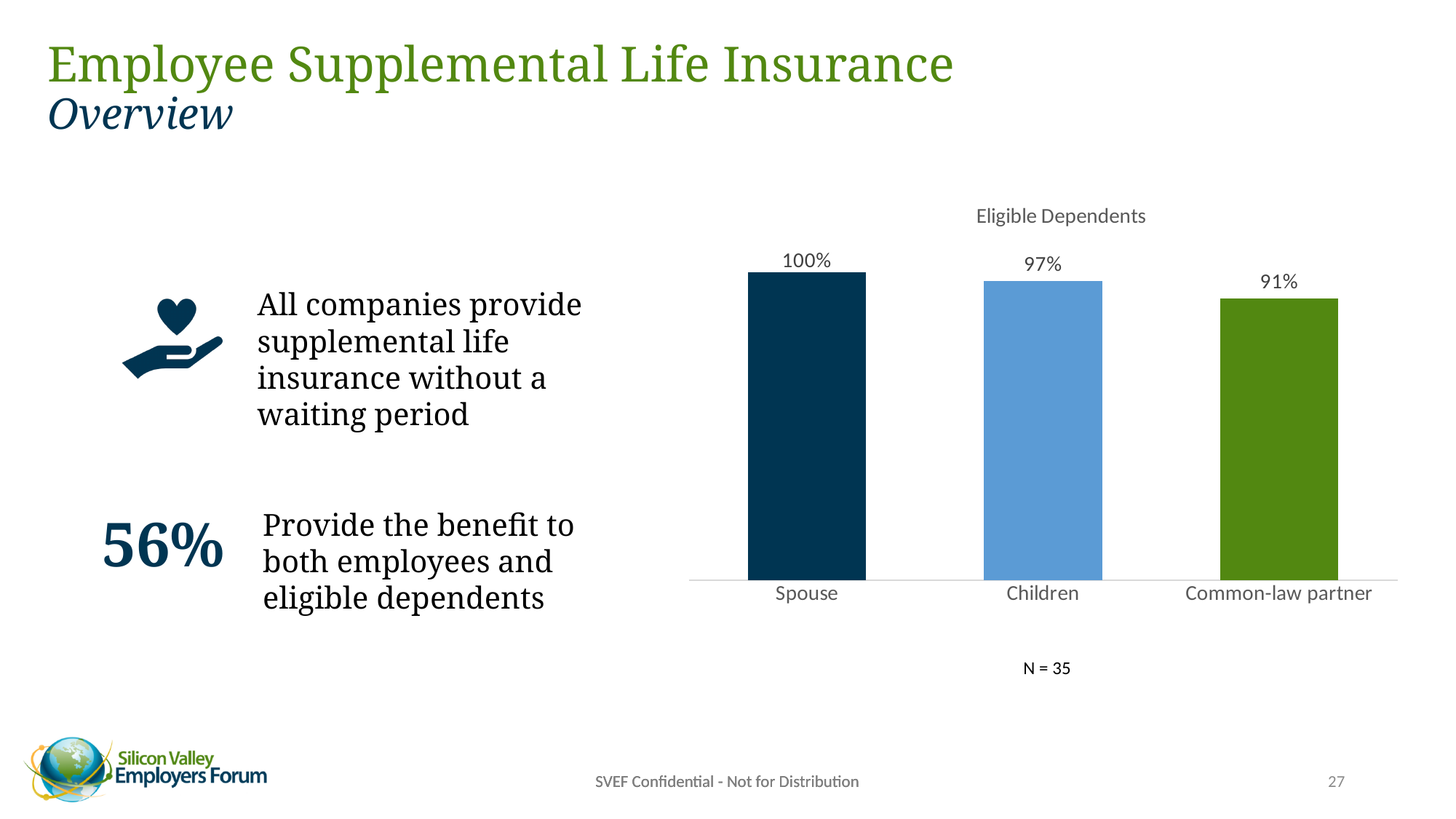
What is the value for Spouse in the Eligible Dependents chart? 100% What kind of chart is the Eligible Dependents chart? Bar chart What is the value for Common-law partner in the Eligible Dependents chart? 91% Do the values rise or fall from left to right across the Eligible Dependents chart? Fall Which category has the lowest value in the Eligible Dependents chart? Common-law partner What is the difference between the values for Children and Common-law partner? 6% Which is larger, the value for Children or the value for Common-law partner? Children Which category has the highest value in the Eligible Dependents chart? Spouse What is the value for Children in the Eligible Dependents chart? 97% How many categories are shown in the Eligible Dependents chart? 3 What is the difference between the values for Spouse and Common-law partner? 9% What is the title of the chart on the slide? Eligible Dependents